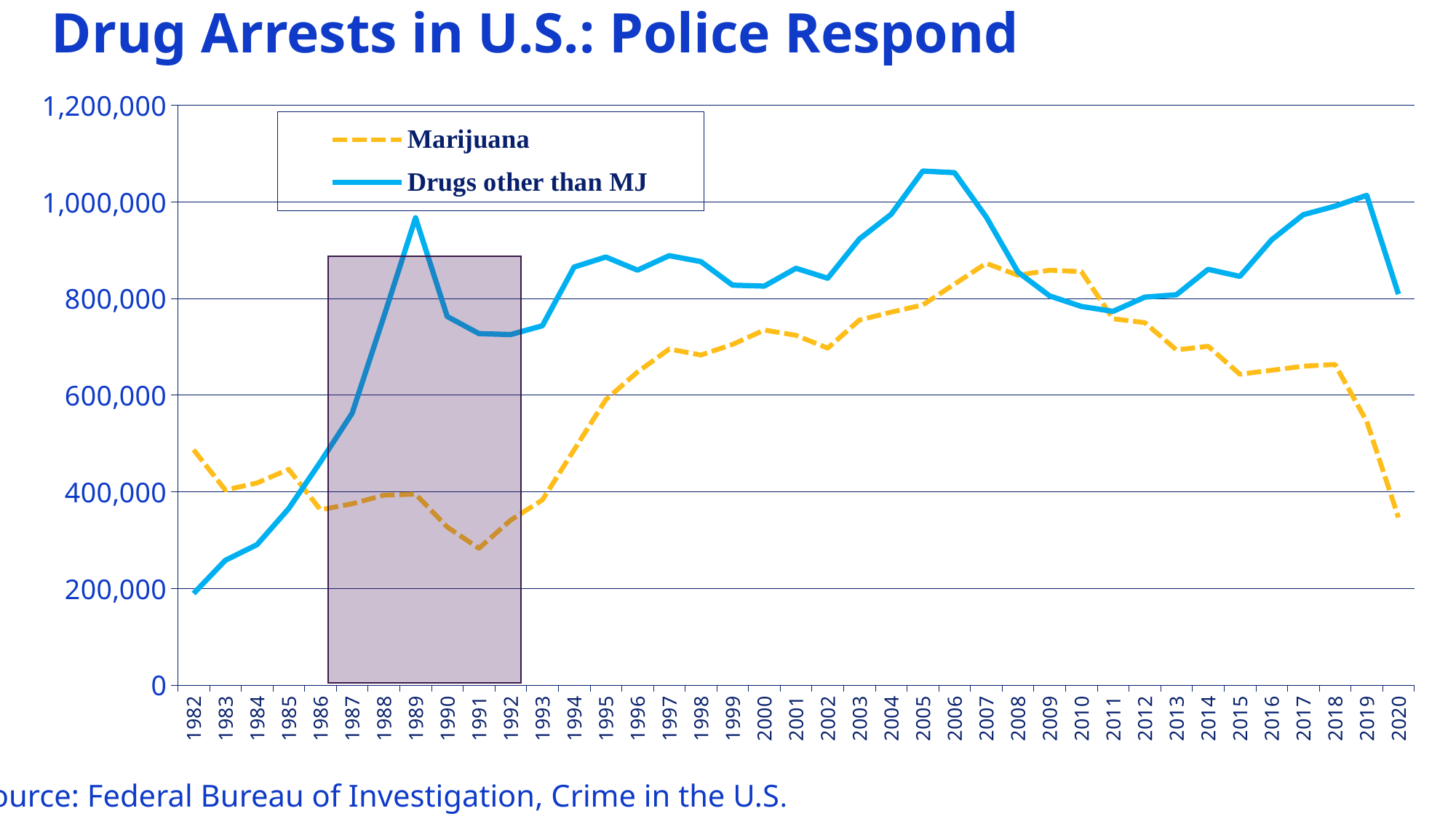
Is the Drugs other than MJ value for 2005 greater or less than 1,000,000? greater In 2010, which series has the higher value, Marijuana or Drugs other than MJ? Marijuana Which two series are listed in the legend? Marijuana; Drugs other than MJ Is the Marijuana value for 2020 greater or less than 400,000? less In which year is the Drugs other than MJ series at its lowest? 1982 How many series does the legend list? 2 In 2020, which series has the higher value, Marijuana or Drugs other than MJ? Drugs other than MJ How many years are plotted along the x axis? 39 In which year is the Marijuana series at its lowest? 1991 Does the Marijuana series rise or fall from 2018 to 2020? Fall Is the Drugs other than MJ value for 1989 greater or less than 800,000? greater What kind of chart is shown on the slide? Line chart